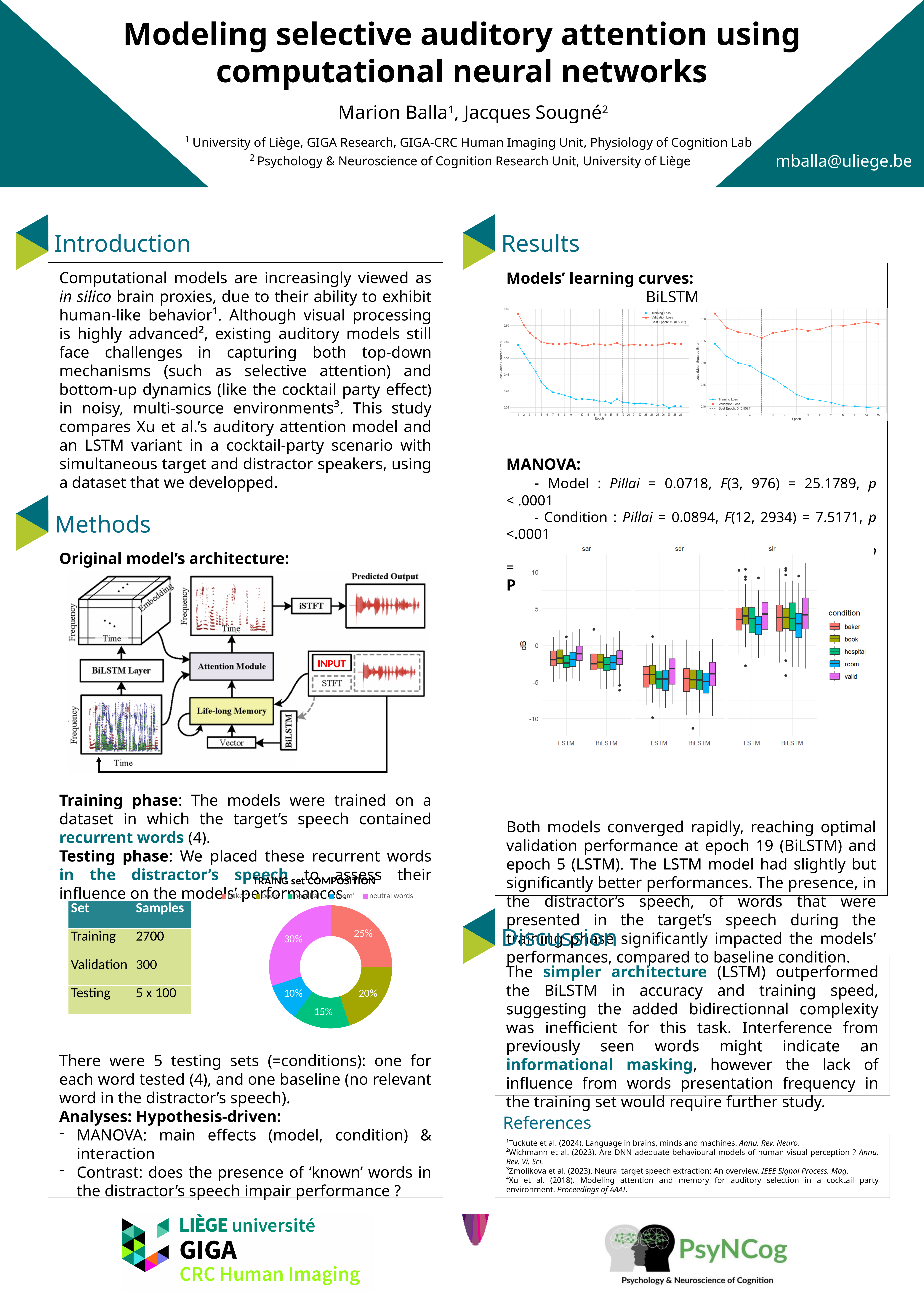
In the 'TRAINING SET COMPOSITION' donut chart, which is larger, the olive slice or the green slice? the olive slice (20%) In the 'TRAINING SET COMPOSITION' donut chart, what share is labelled on the blue slice? 10% In the box plot chart in the Results section, what are the three panel titles? sar, sdr, sir In the 'TRAINING SET COMPOSITION' donut chart, which slice has the largest share? neutral words (30%) In the 'Models' learning curves' line charts, does the training loss rise or fall as the epoch increases? fall In the 'TRAINING SET COMPOSITION' donut chart, what share is labelled on the red slice? 25% In the 'TRAINING SET COMPOSITION' donut chart, what is the difference between the 30% slice and the 15% slice? 15% In the 'TRAINING SET COMPOSITION' donut chart, what share is labelled on the magenta slice for neutral words? 30% In the box plot chart in the Results section, how many conditions does the legend list? 5 In the 'TRAINING SET COMPOSITION' donut chart, how many slices are there? 5 What kind of chart is the 'TRAINING SET COMPOSITION' chart? donut (pie) chart In the 'TRAINING SET COMPOSITION' donut chart, which slice has the smallest share? 10%